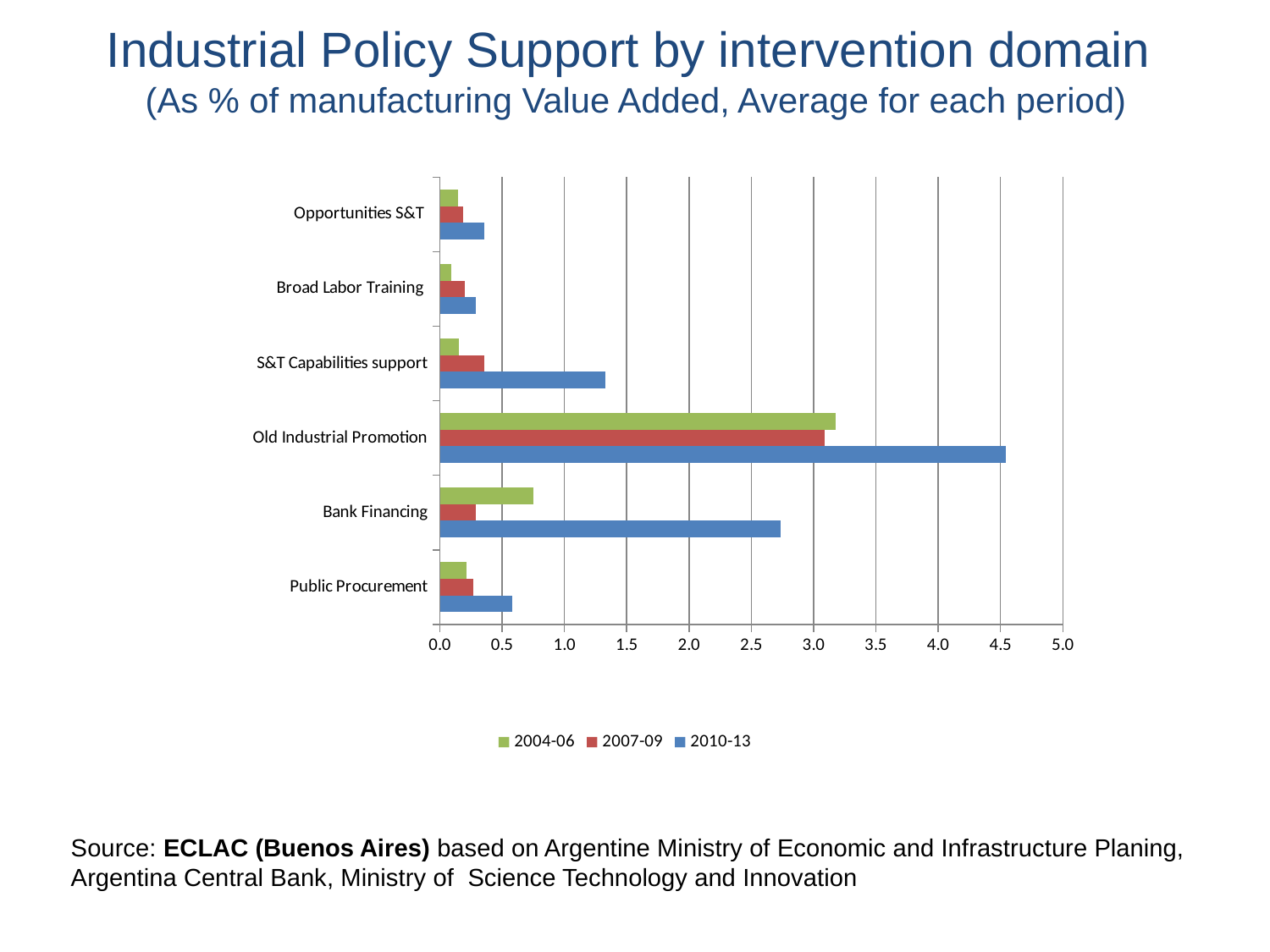
What kind of chart is shown on the slide? Bar chart How many series does the legend list? 3 Which intervention domain has the highest value for 2004-06? Old Industrial Promotion For 2010-13, which is larger: Bank Financing or S&T Capabilities support? Bank Financing Is the 2010-13 value for Old Industrial Promotion greater or less than 4.0? greater How many intervention domains (categories) are shown on the chart? 6 Which intervention domain has the highest value for 2010-13? Old Industrial Promotion Is the 2010-13 value for S&T Capabilities support greater or less than 1.0? greater Is the 2010-13 value for Public Procurement greater or less than 1.0? less For Bank Financing, which period has the larger value: 2004-06 or 2007-09? 2004-06 What are the three periods listed in the legend? 2004-06, 2007-09, 2010-13